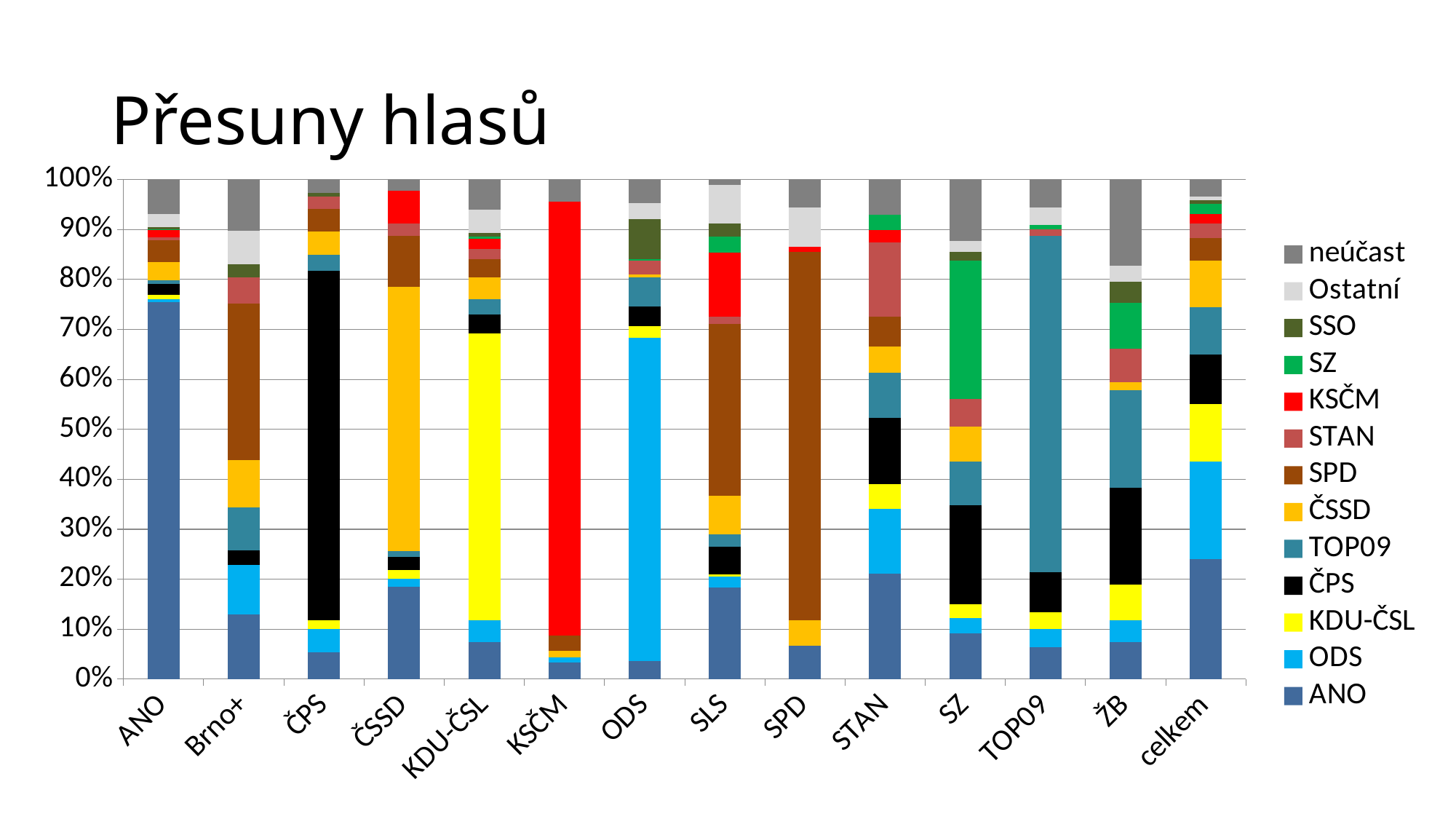
Is the ANO share in the ANO bar greater or less than 70%? greater Is the ANO segment larger in the ANO bar or in the Brno+ bar? ANO Is the ČPS share in the ČPS bar greater or less than 60%? greater What is the title of the chart? Přesuny hlasů What kind of chart is shown on the slide? stacked bar chart Is the ANO share in the celkem bar greater or less than 20%? greater Which bar has the largest KSČM segment? KSČM How many series does the legend list? 13 Which series is shown in red in the legend? KSČM How many categories are shown along the x axis? 14